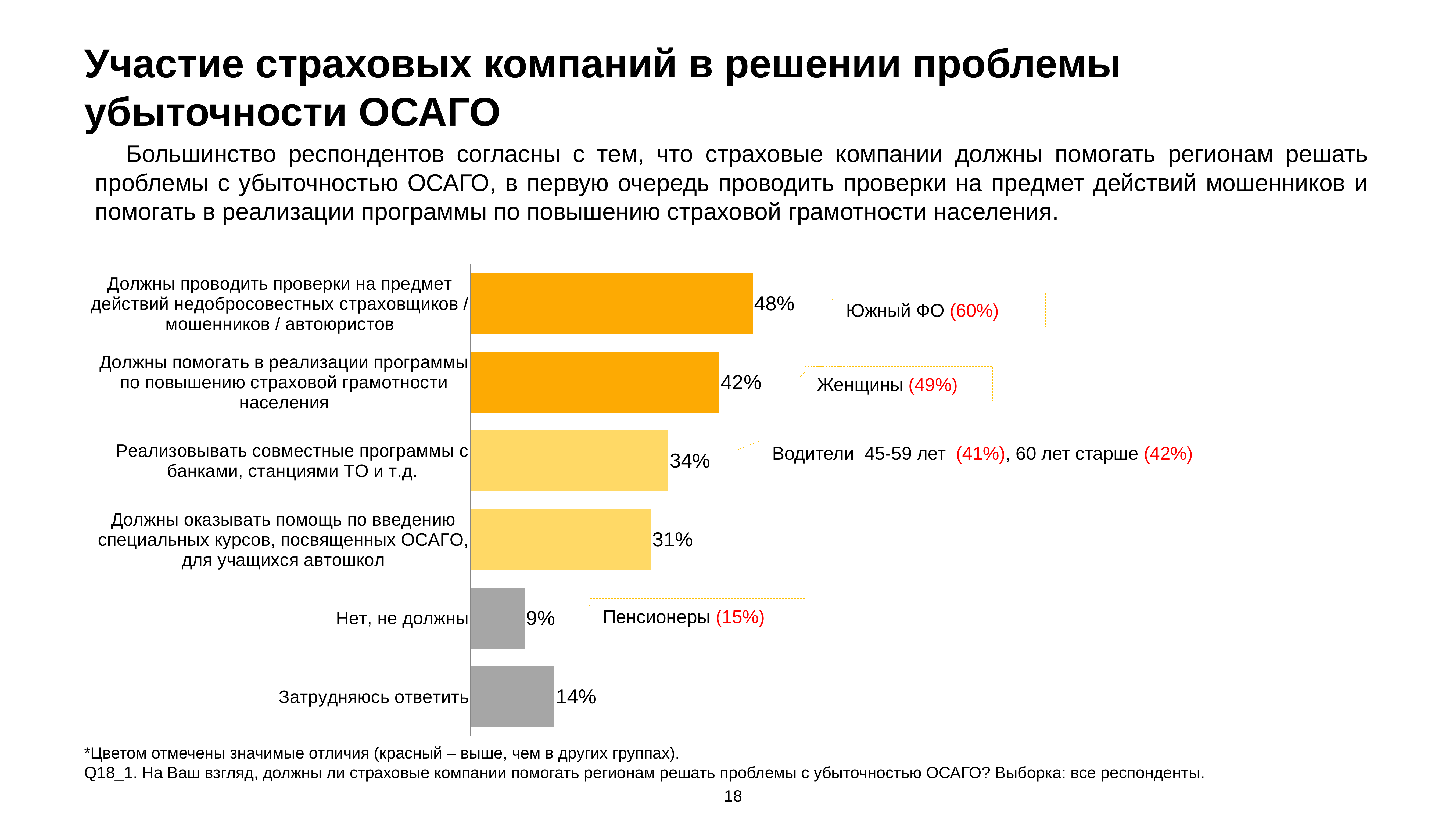
How many categories (bars) are shown in the chart? 6 Which category has the highest value in the chart? Должны проводить проверки на предмет действий недобросовестных страховщиков / мошенников / автоюристов What share of respondents answered "Затрудняюсь ответить"? 14% According to the callout next to "Нет, не должны", what is the value for "Пенсионеры"? 15% What colour are the bars for "Нет, не должны" and "Затрудняюсь ответить"? Grey According to the callout, what is the value for "Южный ФО" on the first bar? 60% What percentage of respondents chose "Должны проводить проверки на предмет действий недобросовестных страховщиков / мошенников / автоюристов"? 48% Which category has the lowest value in the chart? Нет, не должны Which is larger: the value for "Нет, не должны" or for "Затрудняюсь ответить"? Затрудняюсь ответить What is the difference between the values for "Должны проводить проверки..." (48%) and "Должны помогать в реализации программы по повышению страховой грамотности населения" (42%)? 6% What type of chart is shown on the slide? Bar chart What is the value for "Реализовывать совместные программы с банками, станциями ТО и т.д."? 34%